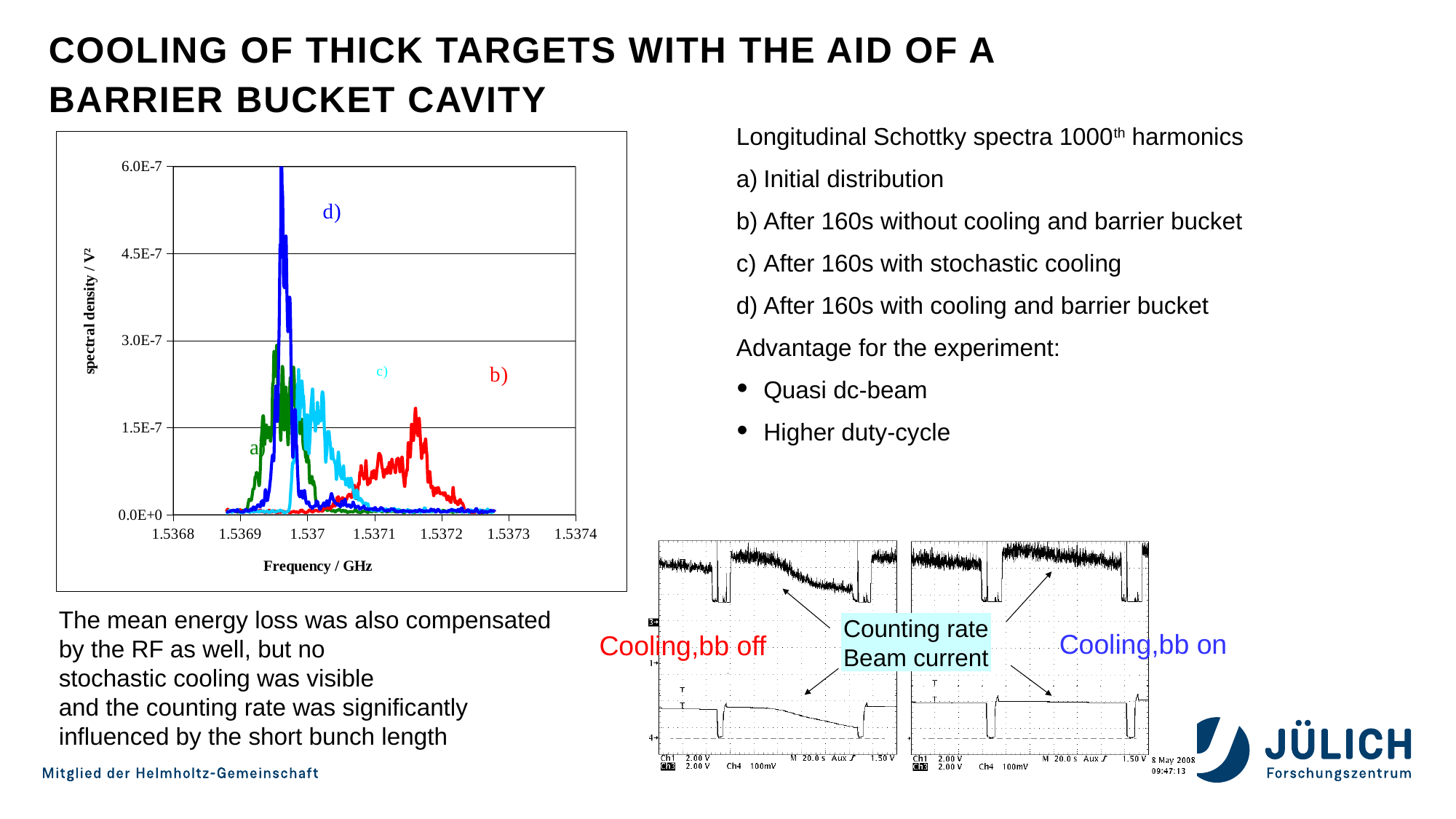
Which curve in the Schottky spectra chart is centred at the highest frequency? b) What colour is curve d) in the Schottky spectra chart? blue How many labelled curves (a, b, c, d) are plotted in the Schottky spectra chart? 4 What is the x-axis label of the Schottky spectra chart? Frequency / GHz What kind of chart is shown on the left of the slide? line chart Is the peak of curve c) in the Schottky spectra chart greater or less than 3.0E-7? less Is the peak of curve b) in the Schottky spectra chart greater or less than 1.5E-7? greater Is the peak of curve b) in the Schottky spectra chart greater or less than 3.0E-7? less Which curve in the Schottky spectra chart has the lowest peak spectral density? b) Which curve in the Schottky spectra chart reaches the highest peak spectral density? d) In the Schottky spectra chart, which curve has the higher peak, d) or b)? d)